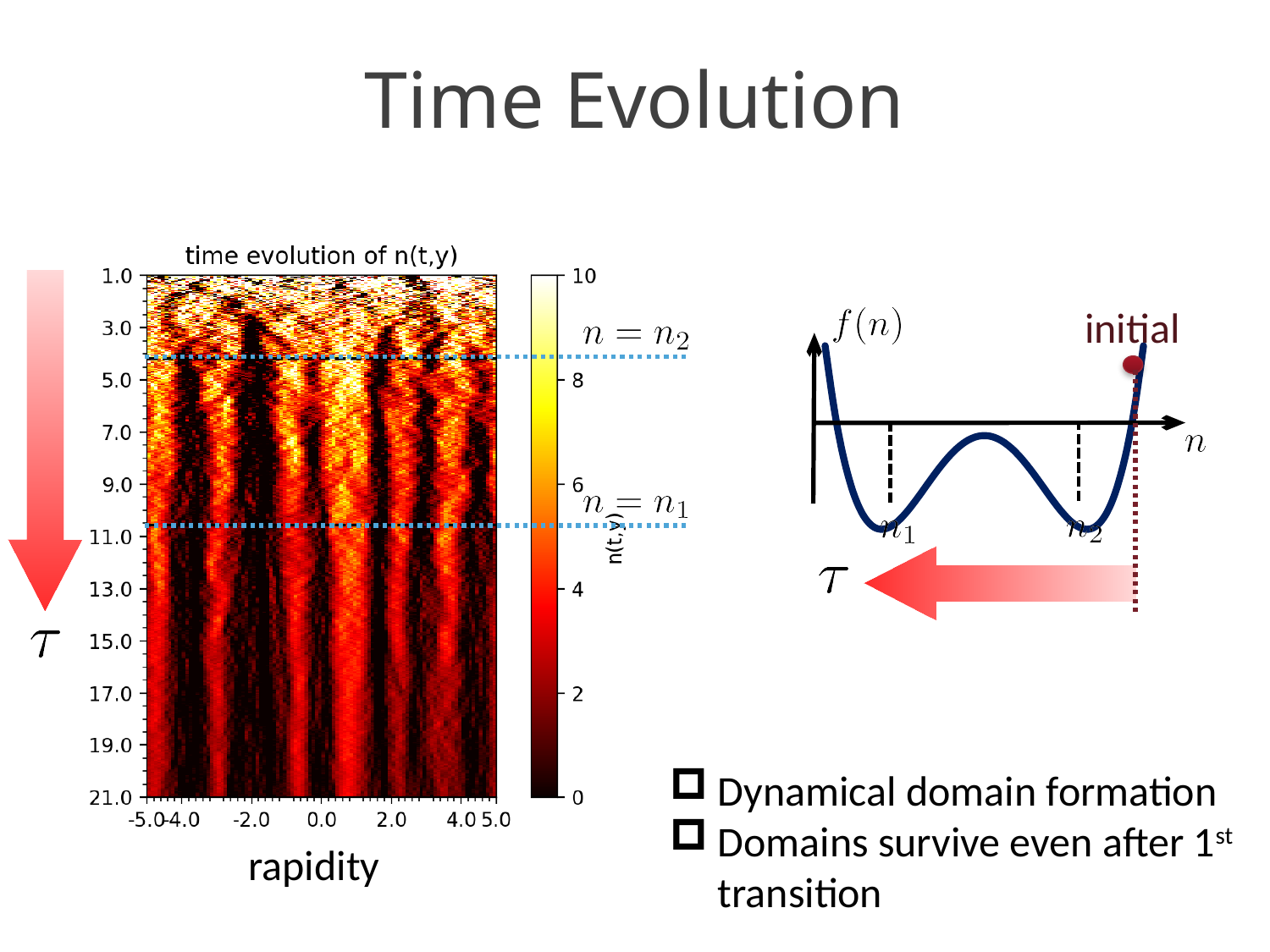
On the left heatmap, which dotted line is at an earlier time, n = n2 or n = n1? n = n2 On the left heatmap, what is the largest tick value on the rapidity axis? 5.0 In the right-hand f(n) curve, what are the labels of the two minima? n1 and n2 In the right-hand f(n) curve, how many minima are labelled? 2 On the left heatmap, what is the smallest tick value on the vertical (time) axis? 1.0 On the left heatmap, what is the largest tick value on the vertical (time) axis? 21.0 What kind of chart is the left plot titled "time evolution of n(t,y)"? heatmap What is the title of the left chart? time evolution of n(t,y) How many dotted horizontal lines are drawn across the left heatmap? 2 On the left heatmap, what is the minimum value shown on the colour bar? 0 On the left heatmap, what is the maximum value shown on the colour bar? 10 What is the x-axis label of the left heatmap? rapidity